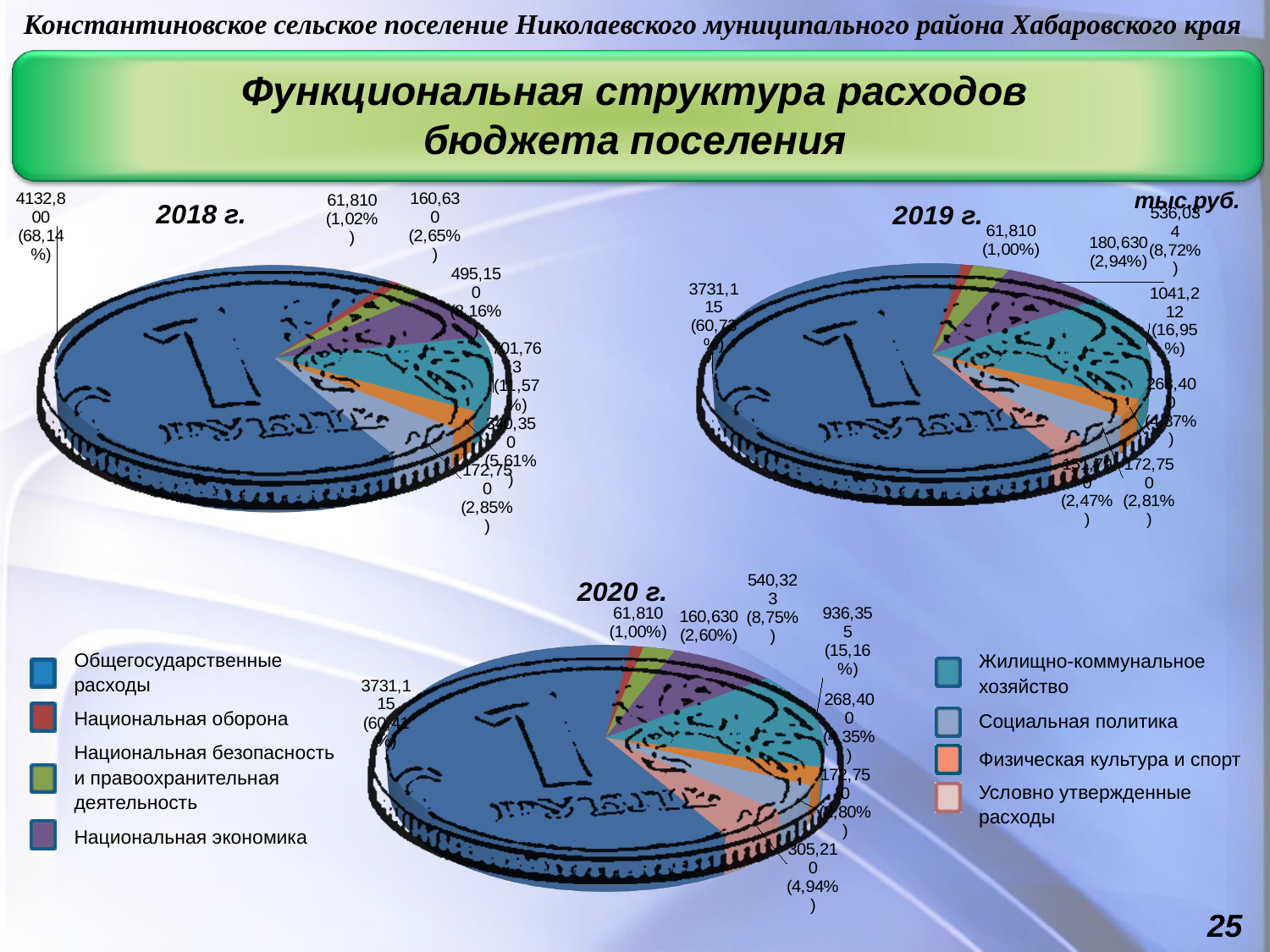
In the 2020 г. pie chart, what percentage share is shown for Национальная безопасность и правоохранительная деятельность? 2,60% Which year shows the larger value for Национальная экономика, 2019 г. (536,034) or 2020 г. (540,323)? 2020 г. In the 2020 г. pie chart, what percentage share is shown for Условно утвержденные расходы? 4,94% In the 2018 г. pie chart, what percentage share does the largest slice (Общегосударственные расходы) have? 68,14% In the 2019 г. pie chart, what value is shown for Национальная экономика? 536,034 In the 2018 г. pie chart, what is the value of the largest slice (Общегосударственные расходы)? 4132,800 What kind of charts are shown on the slide? Pie charts In the 2019 г. pie chart, what is the value labelled for Национальная оборона? 61,810 In the 2020 г. pie chart, what value is shown for Жилищно-коммунальное хозяйство? 936,355 How many pie charts are on the slide? 3 In what units are the values on the slide given? тыс.руб. How many categories does the legend list? 8